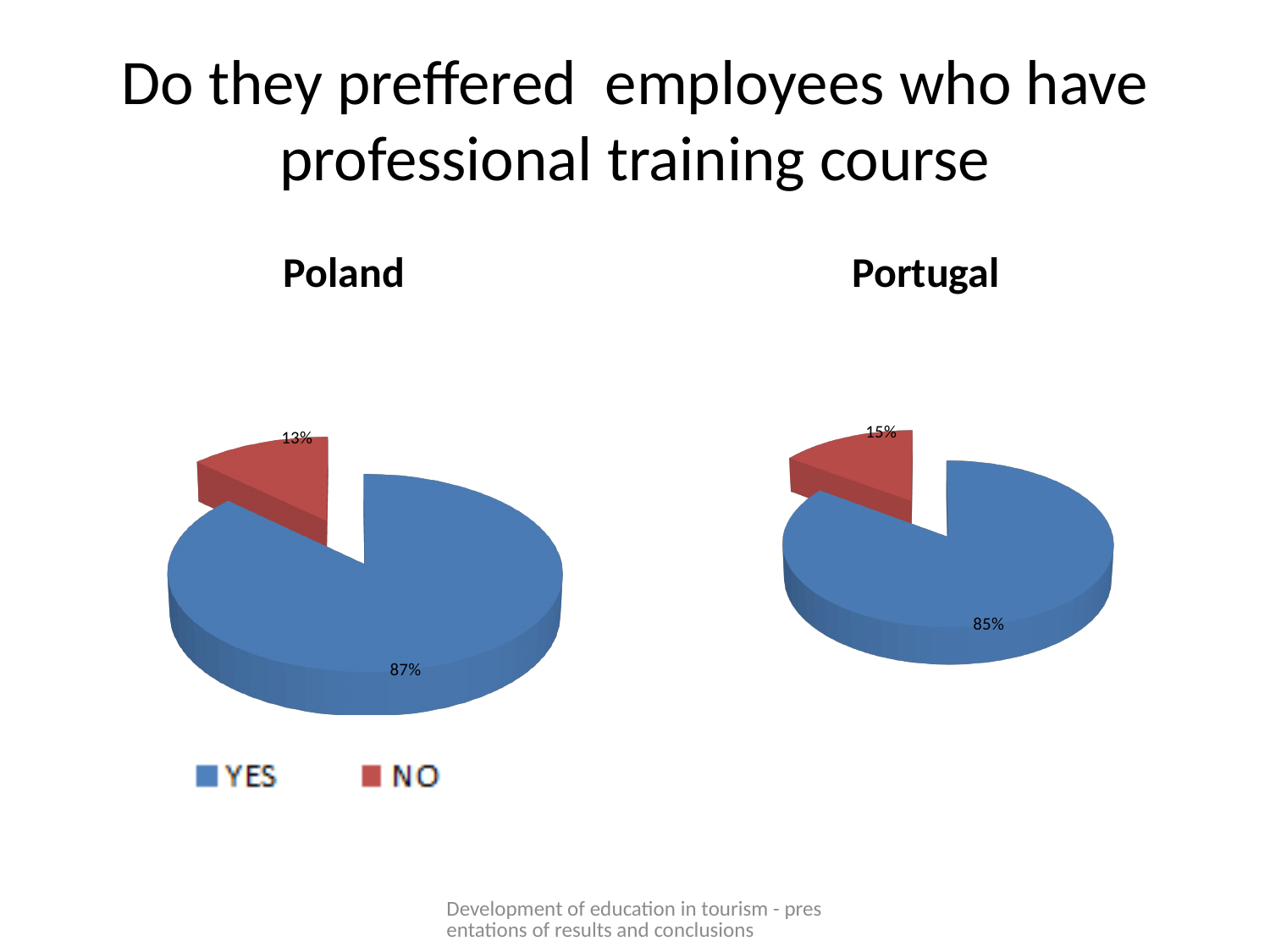
What type of chart is used for Poland and Portugal on this slide? Pie chart What colour represents NO in the pie charts? Red In the Portugal pie chart, what percentage answered YES? 85% In the Portugal pie chart, what percentage answered NO? 15% In the Poland pie chart, what percentage answered NO? 13% How many slices does the Portugal pie chart have? 2 How many entries does the legend list? 2 In the Portugal pie chart, which answer has the smallest share? NO In the Poland pie chart, what percentage answered YES? 87% Which country has the larger YES share, Poland or Portugal? Poland In the Poland pie chart, what is the difference between the YES and NO shares? 74% In the Poland pie chart, which answer has the largest share? YES